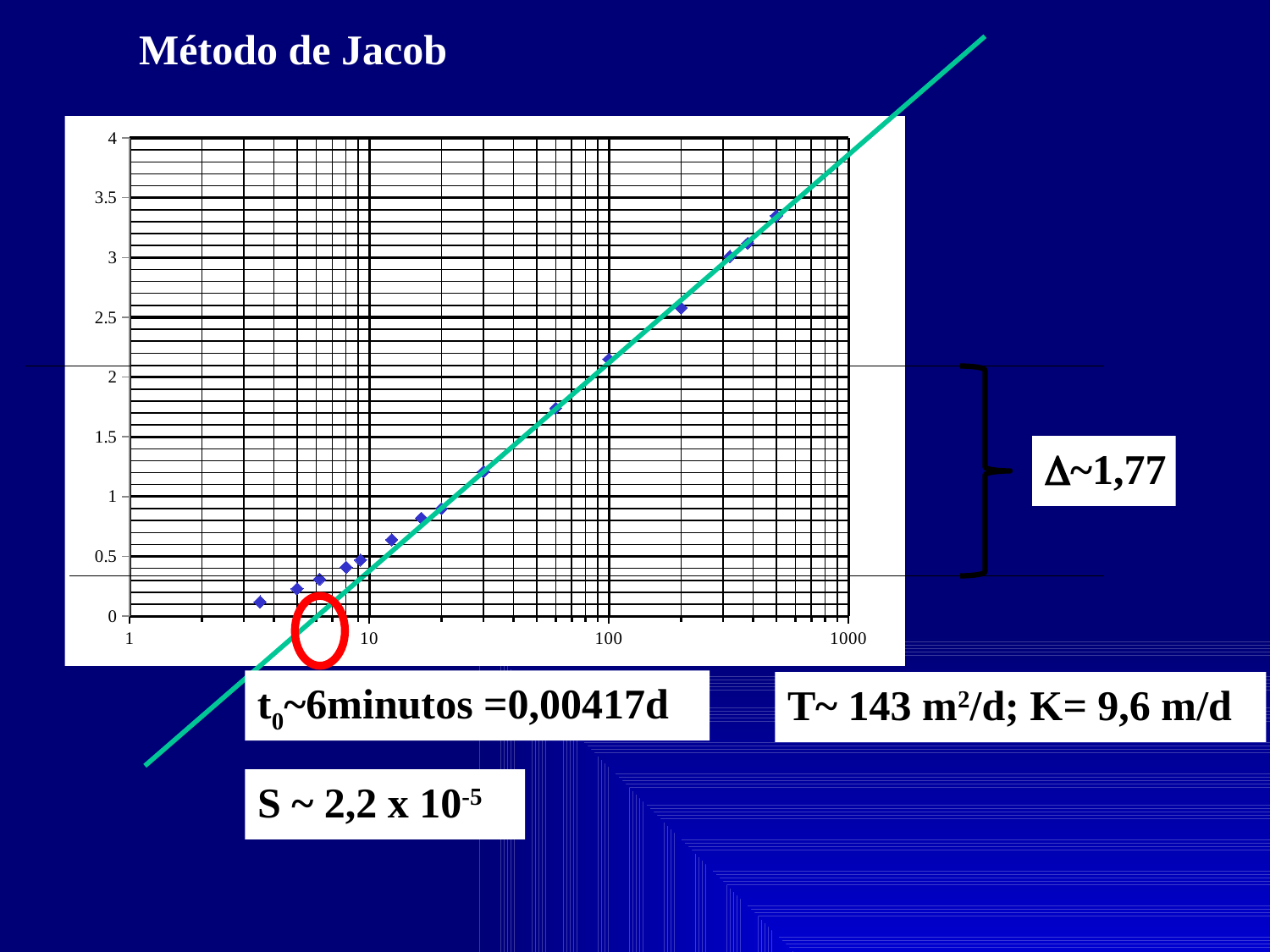
Is the value of the leftmost plotted point greater or less than 0.5? less What kind of chart is shown on the slide? scatter chart Which has the larger value, the point at x = 100 or the point at x = 10? the point at x = 100 Is the value of the point at about x = 30 greater or less than 1? greater What value of t0 is annotated below the chart? t0~6minutos =0,00417d What is the highest tick value shown on the y axis? 4 Is the value of the point at x = 100 greater or less than 1.5? greater Do the plotted values rise or fall as the x axis increases? rise What value of Δ is annotated next to the chart? Δ~1,77 What is the highest tick value shown on the x axis? 1000